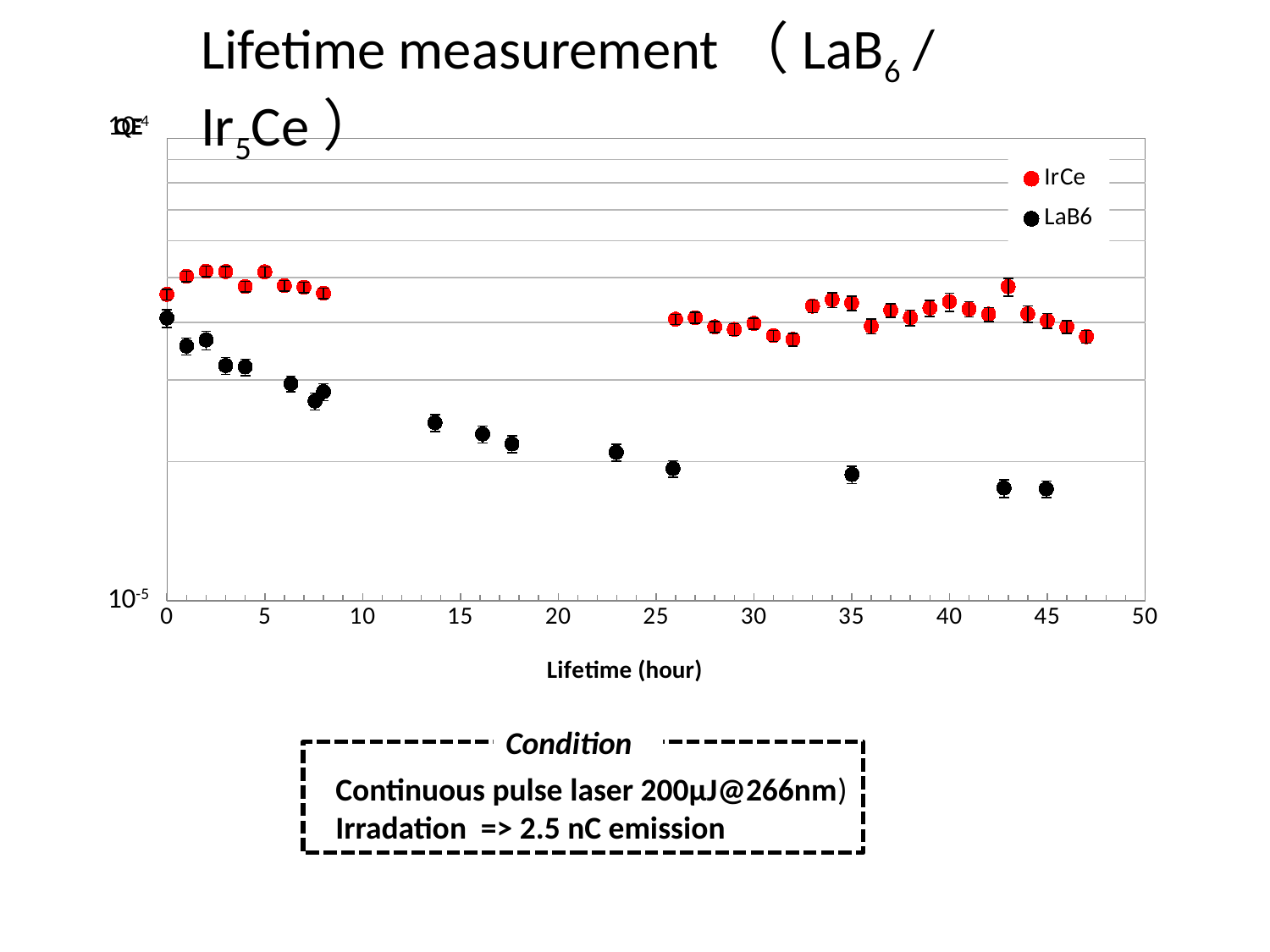
Which series reaches the lowest QE value on the chart? LaB6 What is the maximum value shown on the x axis? 50 Does the LaB6 series rise or fall as lifetime increases from 0 to 45 hours? Fall Which series has the higher QE at 0 hours, IrCe or LaB6? IrCe What are the two series named in the legend? IrCe and LaB6 What is the label of the x axis? Lifetime (hour) Is the QE value for LaB6 at 45 hours greater or less than 10^-4? less Which series stays roughly constant over the measured lifetime? IrCe What kind of chart is shown on the slide? Scatter chart Which series has the higher QE at 45 hours, IrCe or LaB6? IrCe How many series does the legend list? 2